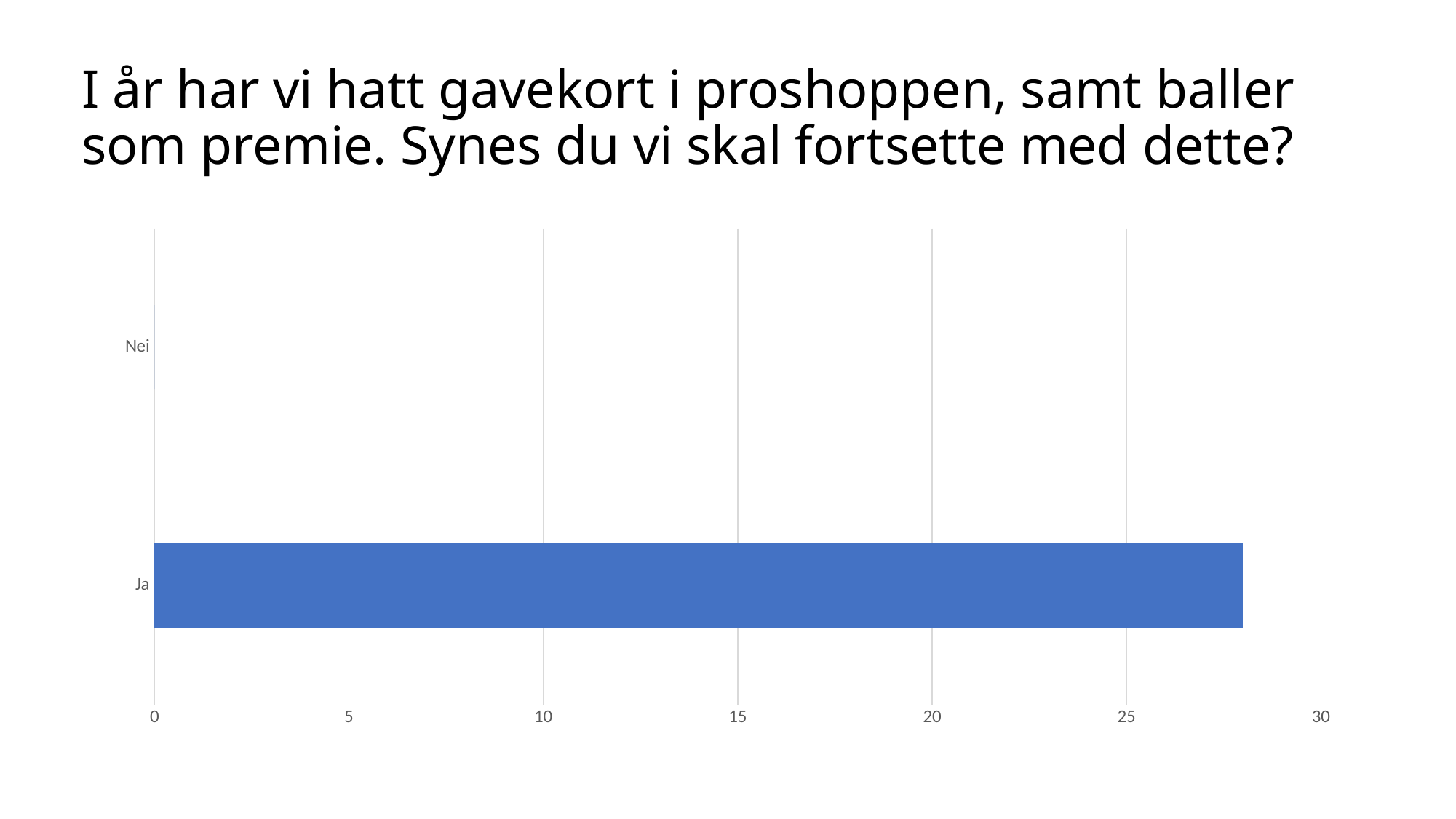
What colour is the bar for Ja? blue Is the value for Nei greater or less than 5? less Which category has the highest value? Ja Which is larger, the value for Ja or the value for Nei? Ja What is the highest value shown on the horizontal axis? 30 Is the value for Ja greater or less than 30? less Which category has the lowest value? Nei What kind of chart is shown on the slide? bar chart How many categories are shown on the chart? 2 Is the value for Ja greater or less than 25? greater